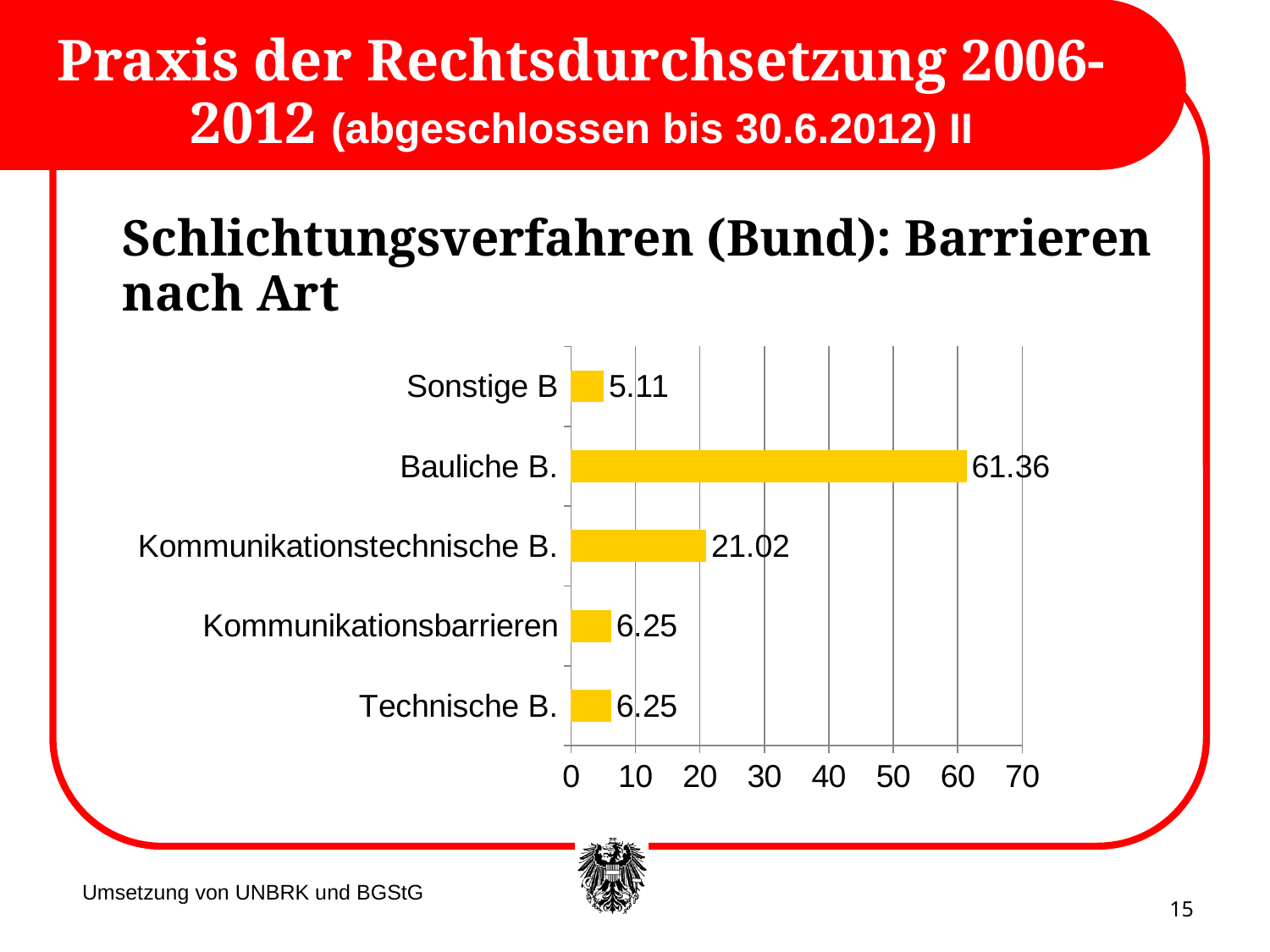
What kind of chart is shown on the slide? bar chart What is the difference between the values for Bauliche B. and Kommunikationstechnische B.? 40.34 Is the value for Bauliche B. greater or less than 50? greater What is the value for Bauliche B.? 61.36 Which category has the highest value? Bauliche B. What is the value for Kommunikationstechnische B.? 21.02 Which is larger, the value for Kommunikationstechnische B. or the value for Technische B.? Kommunikationstechnische B. What is the difference between the values for Kommunikationsbarrieren and Sonstige B? 1.14 How many categories are shown in the chart? 5 Which category has the lowest value? Sonstige B What is the value for Sonstige B? 5.11 What is the value for Technische B.? 6.25